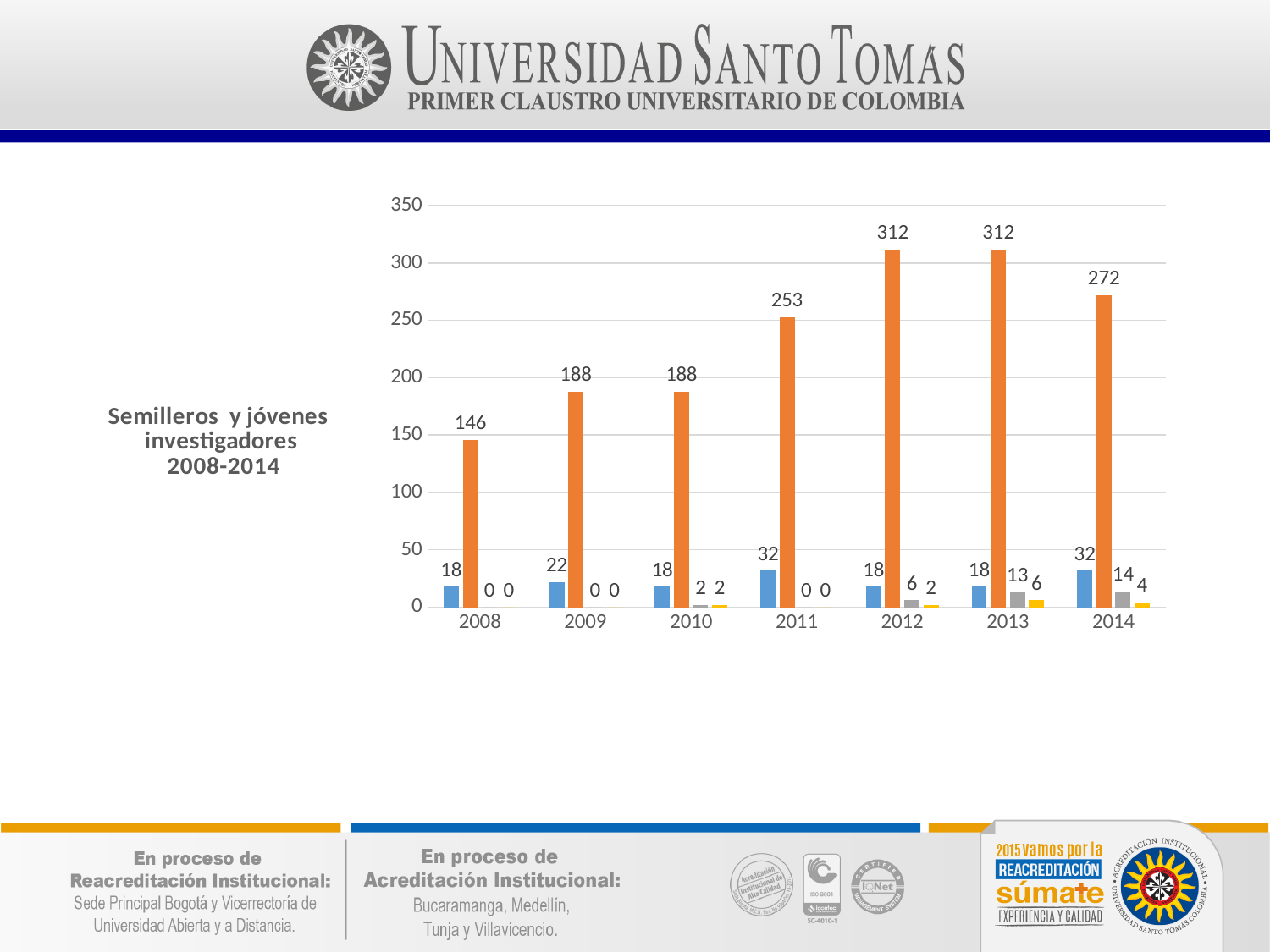
What is the value of the orange bar for 2011? 253 What is the value of the blue bar for 2009? 22 What is the value of the yellow bar for 2014? 4 What is the title text shown beside the chart? Semilleros y jóvenes investigadores 2008-2014 How many years are shown on the x axis? 7 What kind of chart is shown on the slide? Bar chart Which is larger, the orange bar for 2011 or the orange bar for 2014? 2014 In which year is the orange bar lowest? 2008 What is the value of the grey bar for 2013? 13 Is the orange bar for 2011 greater or less than 250? greater What is the difference between the orange bar values for 2012 and 2014? 40 In which year is the grey bar highest? 2014